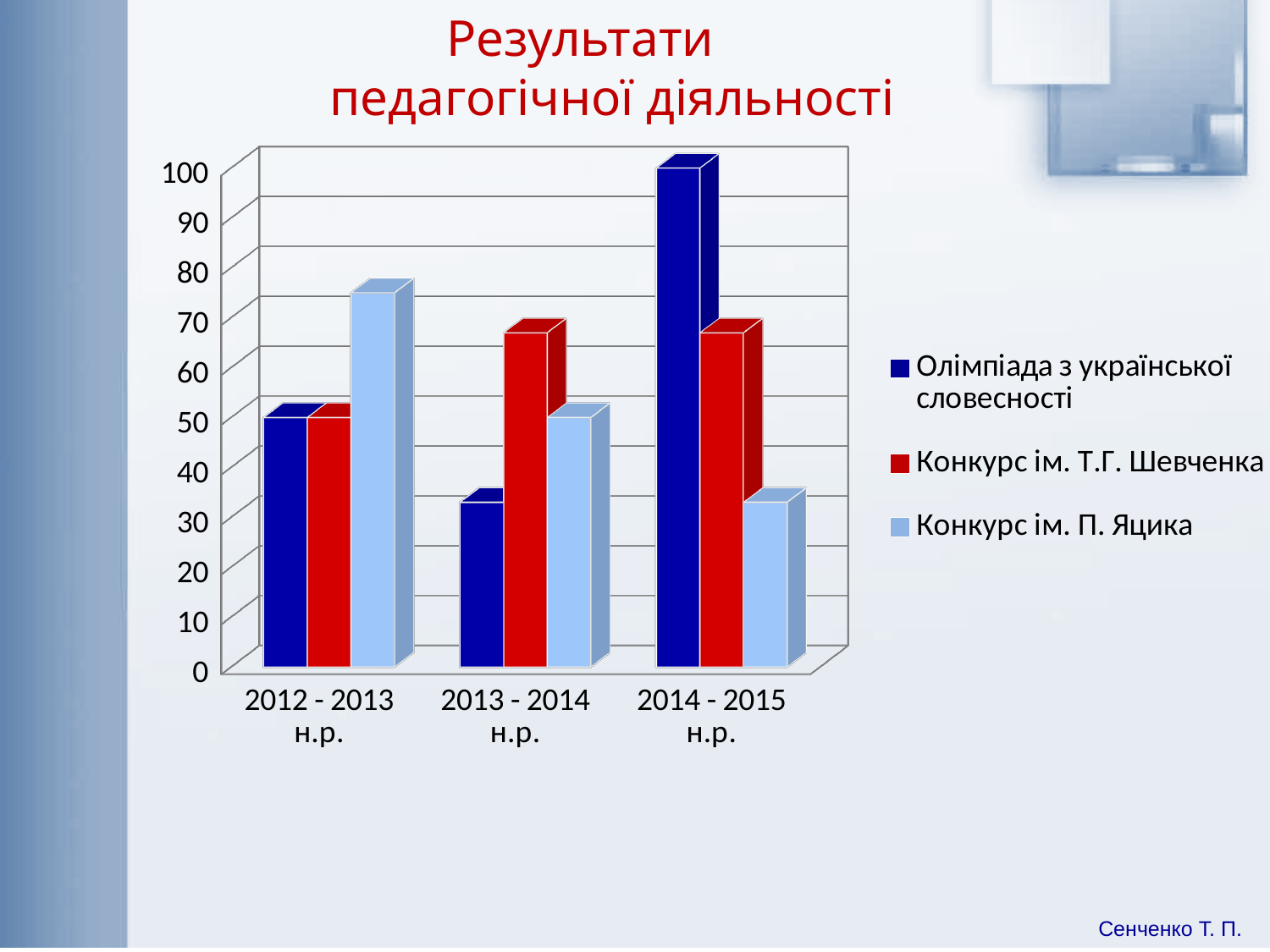
What is the title of the chart on the slide? Результати педагогічної діяльності Which academic year has the lowest value for Олімпіада з української словесності? 2013 - 2014 н.р. Is the value for Конкурс ім. П. Яцика in 2014 - 2015 н.р. greater or less than 40? less What kind of chart is shown on the slide? bar chart Which academic year has the highest value for Олімпіада з української словесності? 2014 - 2015 н.р. Is the value for Олімпіада з української словесності in 2014 - 2015 н.р. greater or less than 90? greater How many series does the legend list? 3 Which academic year has the lowest value for Конкурс ім. П. Яцика? 2014 - 2015 н.р. Does the value for Конкурс ім. П. Яцика rise or fall across the academic years from 2012 - 2013 to 2014 - 2015? fall In 2013 - 2014 н.р., which is larger: Конкурс ім. Т.Г. Шевченка or Олімпіада з української словесності? Конкурс ім. Т.Г. Шевченка In 2012 - 2013 н.р., which series has the highest value? Конкурс ім. П. Яцика How many categories (academic years) are shown on the x axis? 3